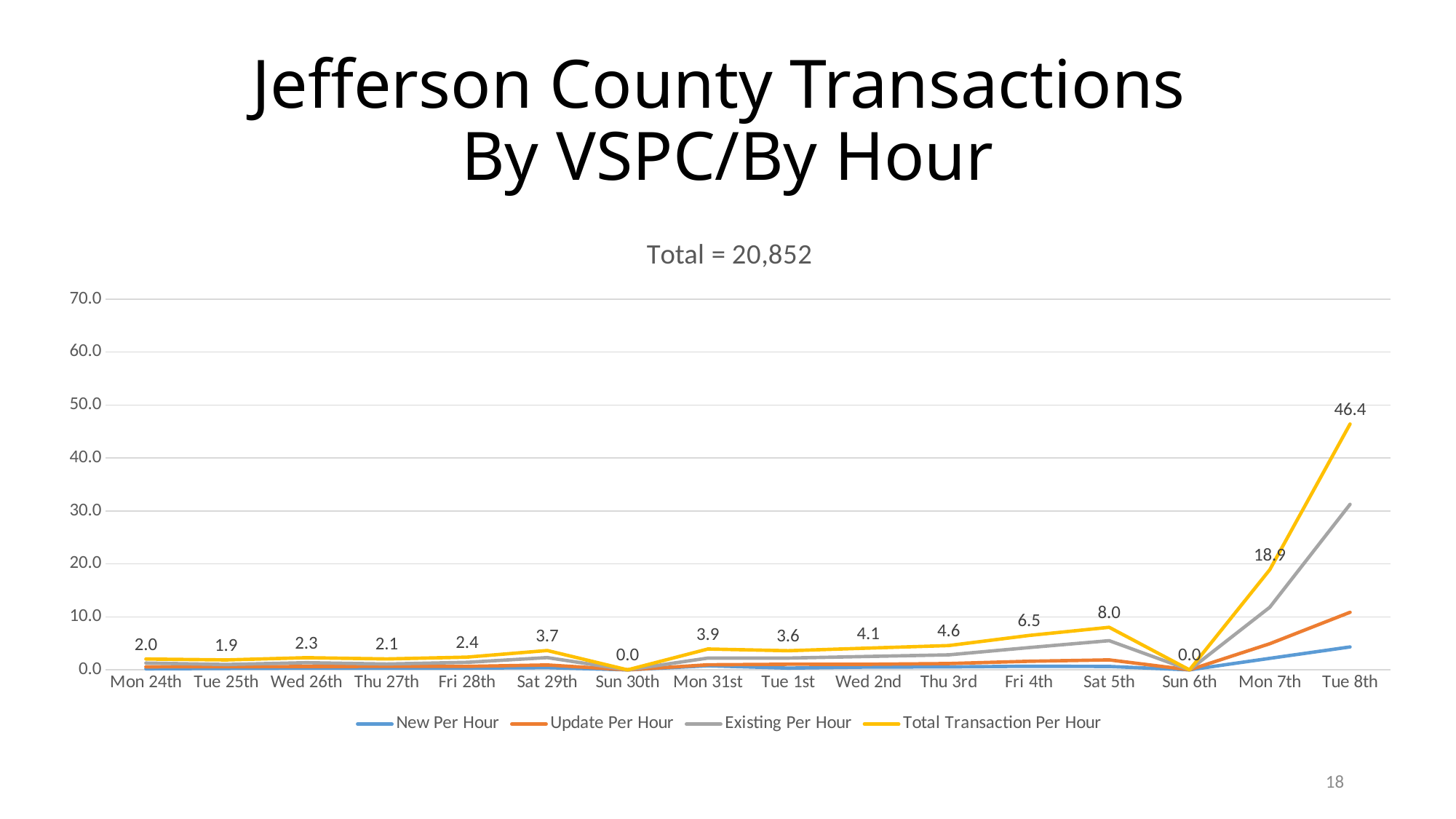
On which date is the Total Transaction Per Hour value highest? Tue 8th What is the Total Transaction Per Hour value for Sat 5th? 8.0 What is the Total Transaction Per Hour value for Tue 8th? 46.4 How many series does the legend list? 4 Which series is drawn in yellow? Total Transaction Per Hour What total is stated in the subtitle above the chart? Total = 20,852 What type of chart is shown on the slide? line chart How many dates are shown along the x axis? 16 What is the Total Transaction Per Hour value for Mon 7th? 18.9 Is the Existing Per Hour value for Tue 8th greater or less than 20.0? greater Which is larger, the Total Transaction Per Hour value for Fri 4th or for Sat 29th? Fri 4th What is the difference between the Total Transaction Per Hour values for Tue 8th and Mon 7th? 27.5